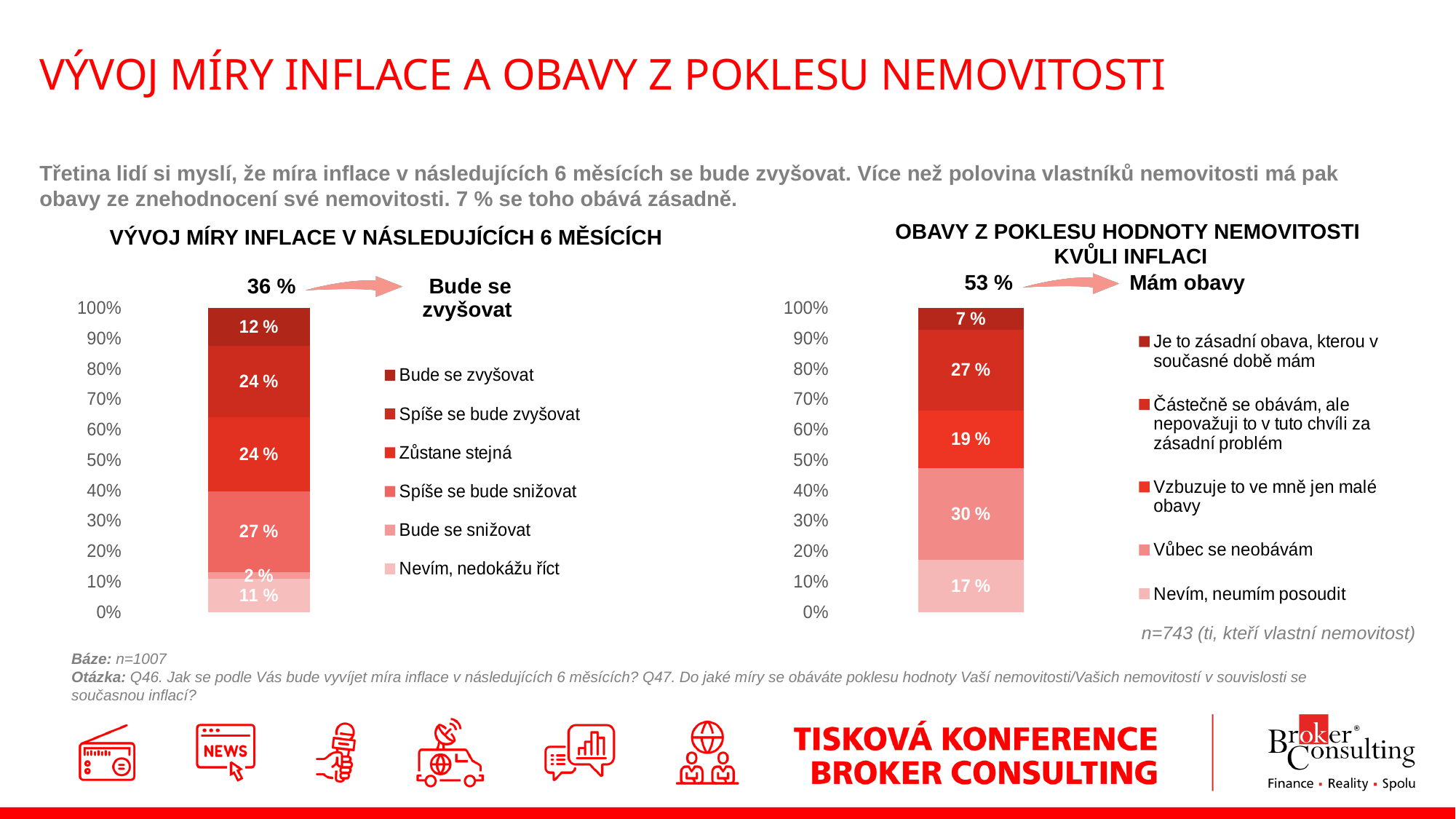
In the chart 'VÝVOJ MÍRY INFLACE V NÁSLEDUJÍCÍCH 6 MĚSÍCÍCH', which segment has the smallest value? Bude se snižovat In the chart 'VÝVOJ MÍRY INFLACE V NÁSLEDUJÍCÍCH 6 MĚSÍCÍCH', what is the value for 'Spíše se bude snižovat'? 27 % In the chart 'VÝVOJ MÍRY INFLACE V NÁSLEDUJÍCÍCH 6 MĚSÍCÍCH', what is the difference between 'Spíše se bude snižovat' and 'Nevím, nedokážu říct'? 16 % In the chart 'VÝVOJ MÍRY INFLACE V NÁSLEDUJÍCÍCH 6 MĚSÍCÍCH', what is the value for 'Bude se zvyšovat'? 12 % In the chart 'OBAVY Z POKLESU HODNOTY NEMOVITOSTI KVŮLI INFLACI', what is the difference between 'Vůbec se neobávám' and 'Nevím, neumím posoudit'? 13 % In the chart 'OBAVY Z POKLESU HODNOTY NEMOVITOSTI KVŮLI INFLACI', which is larger: 'Částečně se obávám, ale nepovažuji to v tuto chvíli za zásadní problém' or 'Vzbuzuje to ve mně jen malé obavy'? Částečně se obávám, ale nepovažuji to v tuto chvíli za zásadní problém In the chart 'OBAVY Z POKLESU HODNOTY NEMOVITOSTI KVŮLI INFLACI', what is the value for 'Vůbec se neobávám'? 30 % What type of chart is 'OBAVY Z POKLESU HODNOTY NEMOVITOSTI KVŮLI INFLACI'? Stacked bar chart In the chart 'OBAVY Z POKLESU HODNOTY NEMOVITOSTI KVŮLI INFLACI', which segment has the largest value? Vůbec se neobávám How many series does the legend of the chart 'OBAVY Z POKLESU HODNOTY NEMOVITOSTI KVŮLI INFLACI' list? 5 How many series does the legend of the chart 'VÝVOJ MÍRY INFLACE V NÁSLEDUJÍCÍCH 6 MĚSÍCÍCH' list? 6 In the chart 'OBAVY Z POKLESU HODNOTY NEMOVITOSTI KVŮLI INFLACI', what is the value for 'Je to zásadní obava, kterou v současné době mám'? 7 %